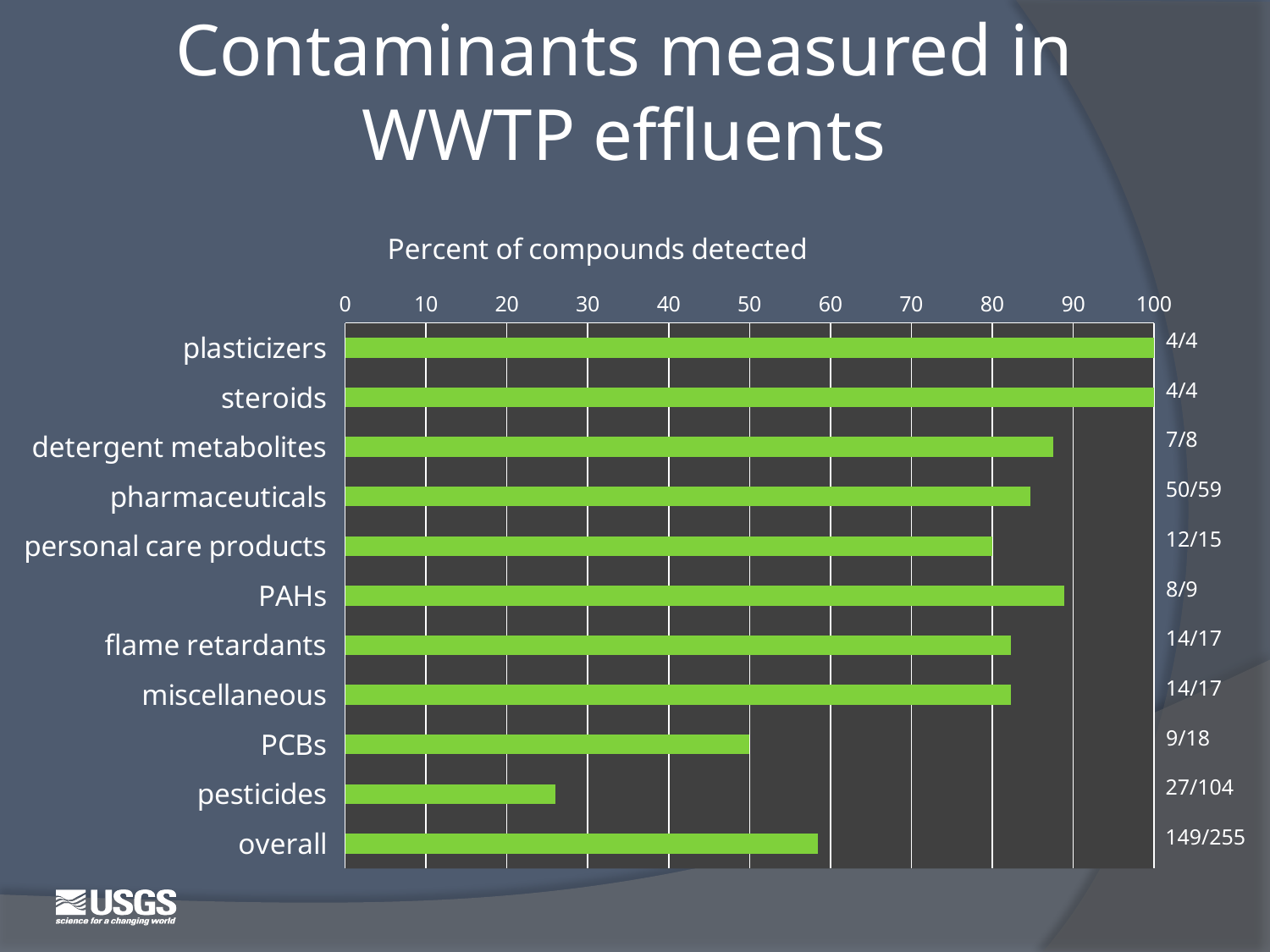
Which category has the lowest percent of compounds detected? pesticides What is the percent of compounds detected for plasticizers? 100 What is the title shown above the chart's axis? Percent of compounds detected Which has a higher percent of compounds detected, PCBs or pesticides? PCBs Is the value for pesticides greater or less than 30? less What is the percent of compounds detected for personal care products? 80 What fraction label is shown next to the overall bar? 149/255 How many categories are plotted on the chart? 11 What fraction label is shown next to the pesticides bar? 27/104 Is the value for overall greater or less than 50? greater What is the percent of compounds detected for PCBs? 50 What type of chart is shown on the slide? bar chart